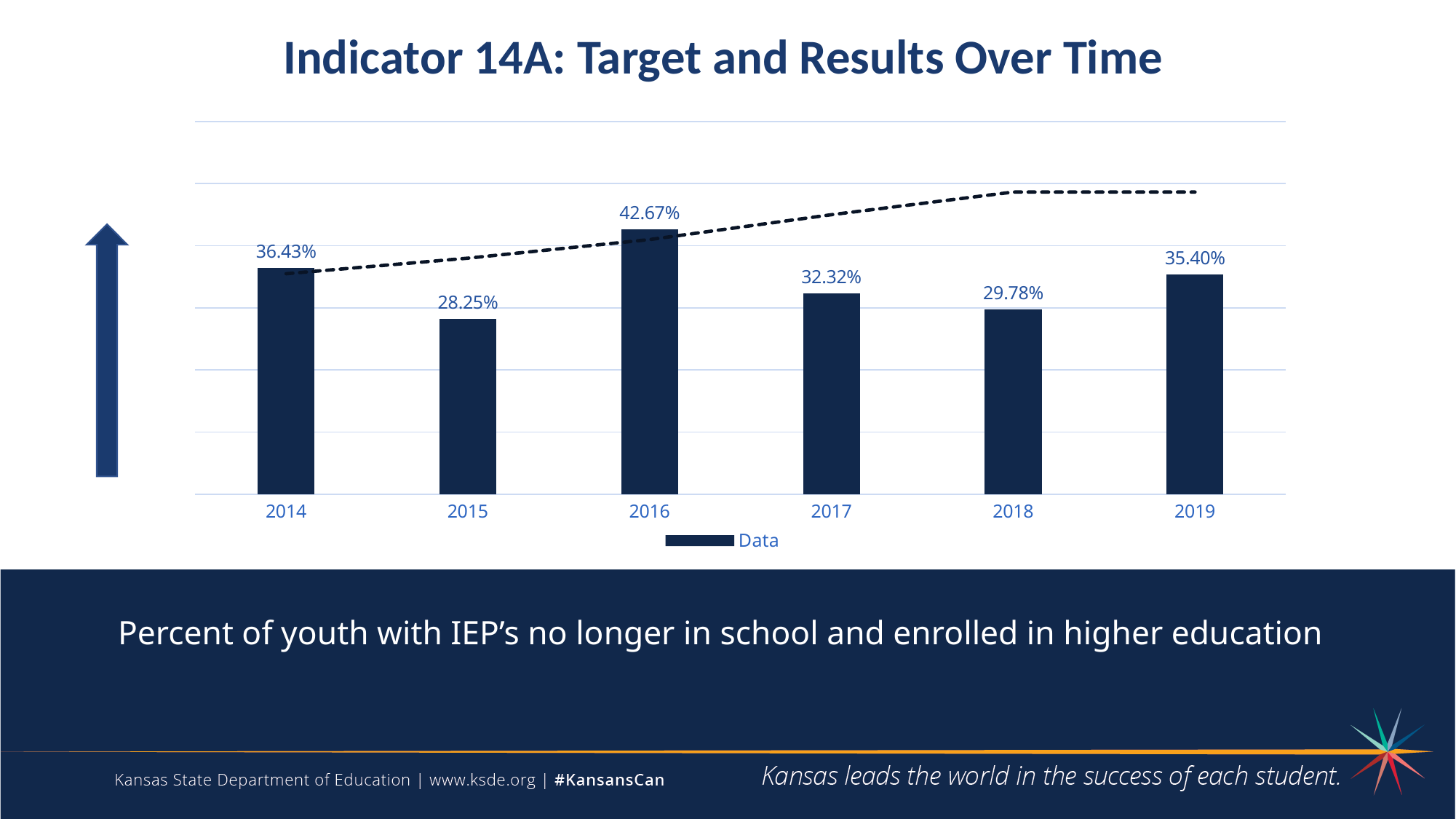
What is the difference between the values for 2019 and 2018? 5.62 percentage points What is the difference between the values for 2016 and 2015? 14.42 percentage points What is the title of the chart? Indicator 14A: Target and Results Over Time What is the value for 2018? 29.78% How many years are shown on the x axis? 6 What is the value for 2014? 36.43% What is the value for 2016? 42.67% What is the value for 2019? 35.40% Which year has the lowest value? 2015 What kind of chart is shown on the slide? Combination bar and line chart Which year has the highest value? 2016 Which is larger, the value for 2014 or the value for 2017? 2014